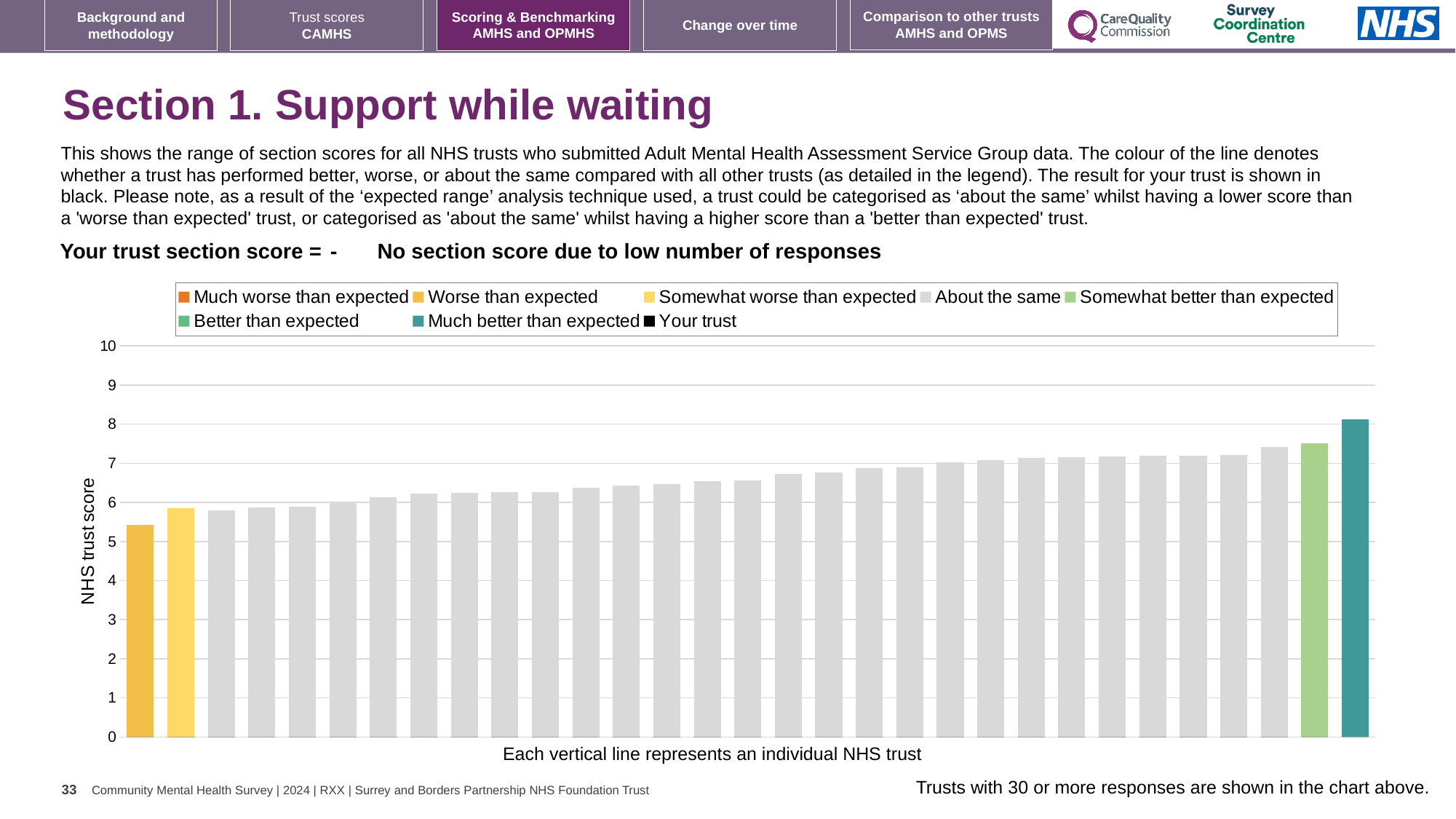
What is the label on the vertical axis of the chart? NHS trust score According to the chart's x-axis caption, what does each vertical line represent? An individual NHS trust Do the bar values rise or fall from left to right across the chart? Rise Is the value of the rightmost bar greater or less than 7? greater How many entries does the chart legend list? 8 Is the value of the leftmost bar greater or less than 5? greater Is the value of the tallest bar greater or less than 9? less How many bars are coloured as 'Somewhat better than expected'? 1 Which legend category does the shortest bar belong to? Worse than expected What kind of chart is shown on the slide? Bar chart Which legend category does the tallest bar belong to? Much better than expected